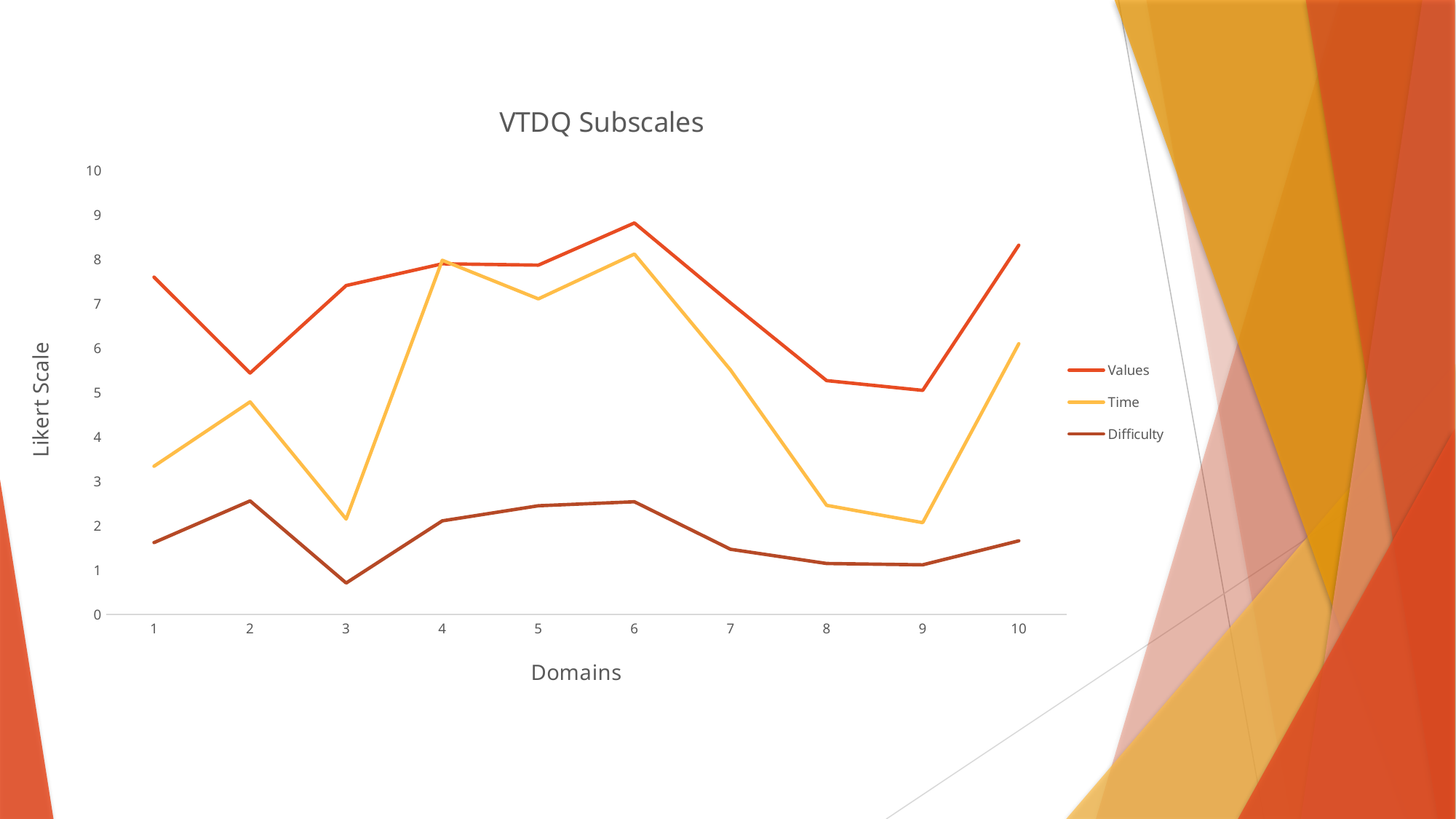
Is the value for the Time series at domain 3 greater or less than 3? less At which domain does the Values series reach its highest point? 6 What is the title of the chart? VTDQ Subscales Does the Time series rise or fall from domain 6 to domain 9? fall Is the value for the Values series at domain 6 greater or less than 8? greater Is the value for the Difficulty series at domain 3 greater or less than 1? less At which domain does the Difficulty series reach its lowest point? 3 How many series does the legend list? 3 At domain 1, which series has the larger value, Values or Time? Values What kind of chart is shown on the slide? line chart How many domains are plotted along the x axis? 10